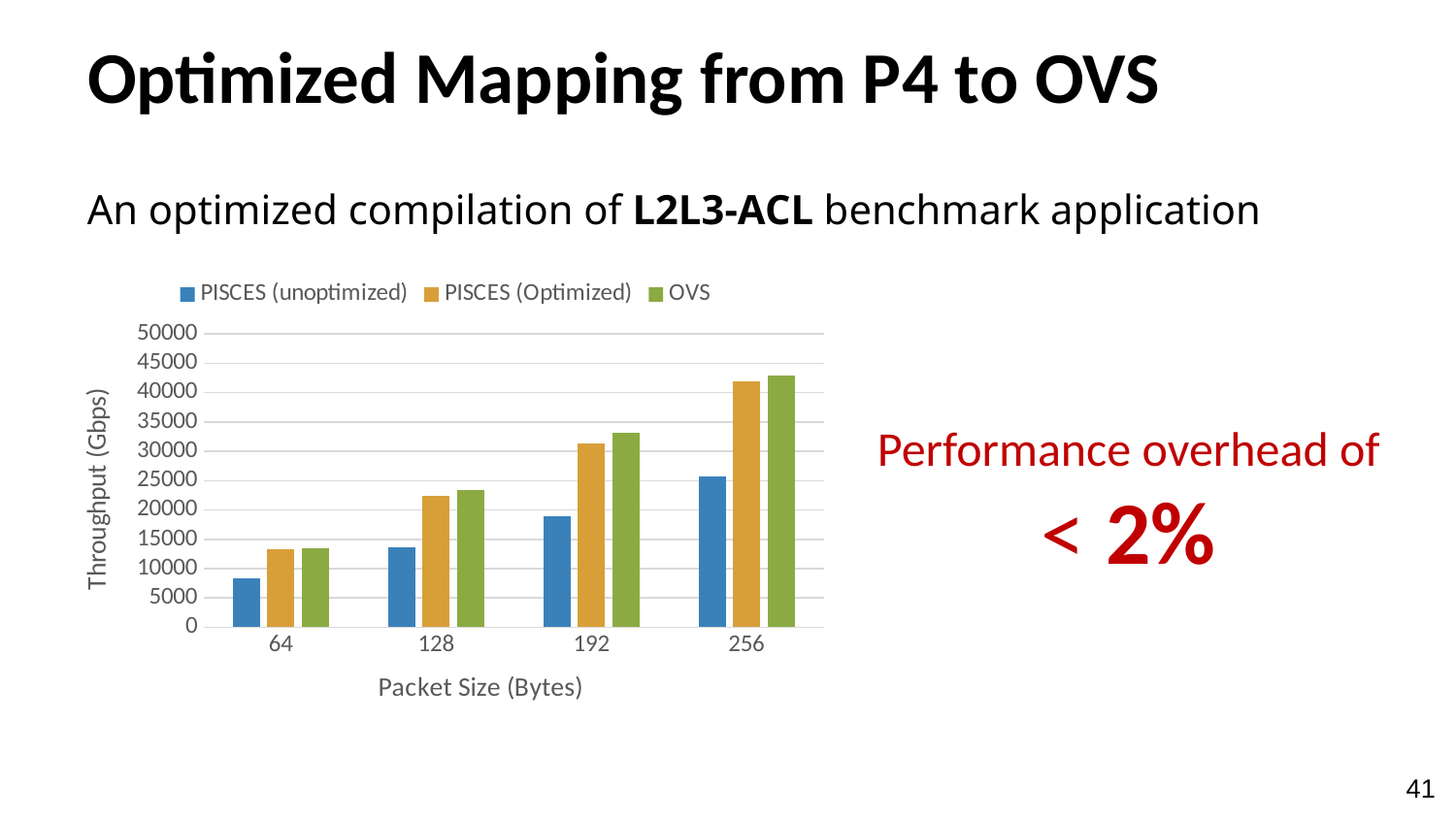
How many series does the chart legend list? 3 At which packet size is the PISCES (unoptimized) throughput lowest? 64 At which packet size is the OVS throughput highest? 256 Is the PISCES (Optimized) throughput at packet size 128 greater or less than 20000? greater What kind of chart is shown on the slide? bar chart What is the label of the chart's y axis? Throughput (Gbps) Does the OVS throughput rise or fall as packet size increases along the x axis? rise How many packet sizes are shown on the x axis of the chart? 4 Is the PISCES (unoptimized) throughput at packet size 256 greater or less than 30000? less Is the PISCES (unoptimized) throughput at packet size 64 greater or less than 10000? less At packet size 192, which is larger: PISCES (Optimized) or PISCES (unoptimized)? PISCES (Optimized)